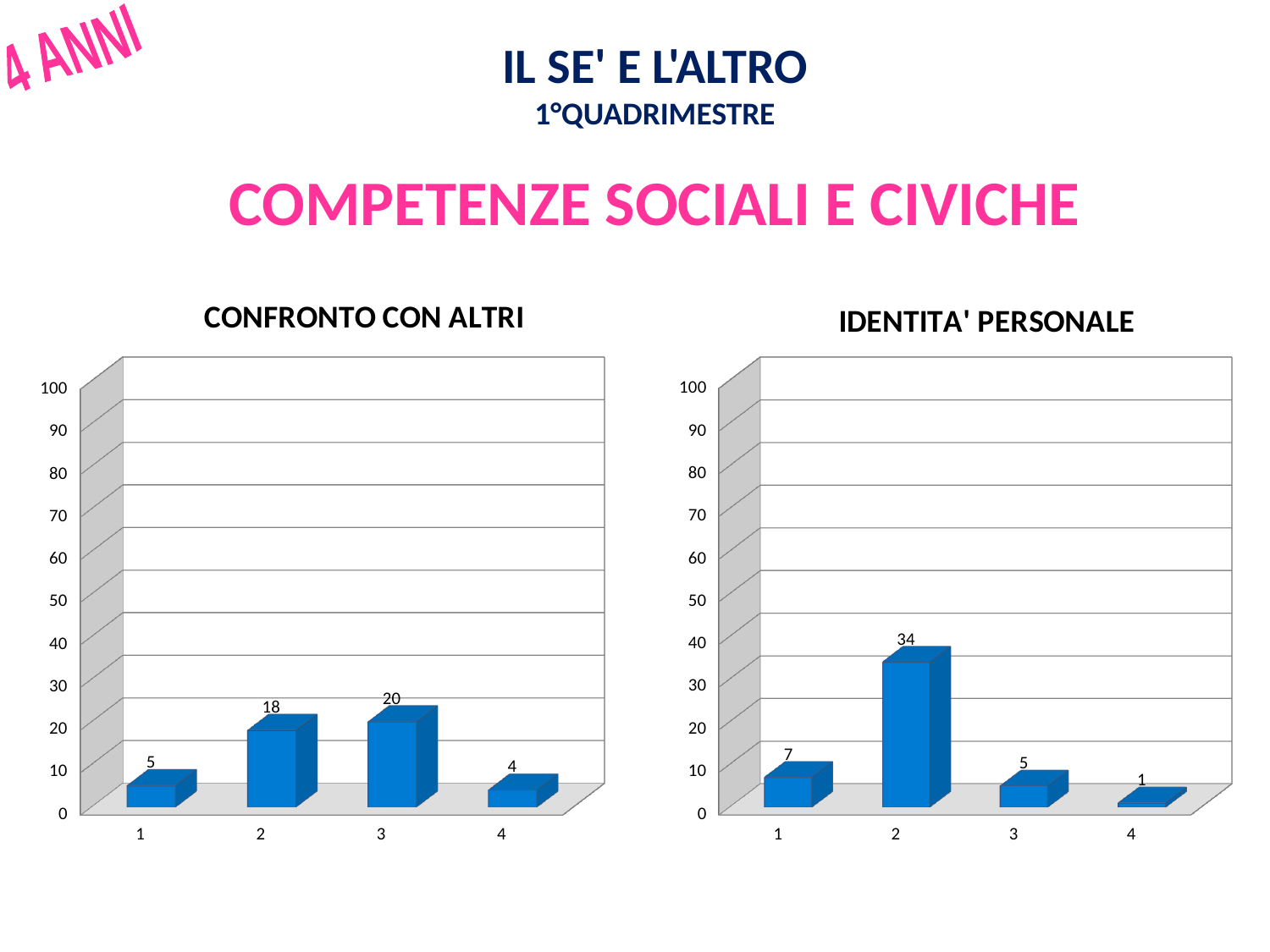
In the CONFRONTO CON ALTRI chart, what is the difference between the values for category 3 and category 1? 15 How many categories are shown in the CONFRONTO CON ALTRI chart? 4 In the IDENTITA' PERSONALE chart, what is the value for category 1? 7 In the CONFRONTO CON ALTRI chart, what is the value for category 4? 4 In the IDENTITA' PERSONALE chart, what is the difference between the values for category 2 and category 3? 29 In the CONFRONTO CON ALTRI chart, which category has the highest value? 3 In the CONFRONTO CON ALTRI chart, what is the value for category 2? 18 In the IDENTITA' PERSONALE chart, is the value for category 2 greater or less than 30? greater In the IDENTITA' PERSONALE chart, which is larger: the value for category 1 or the value for category 3? category 1 In the IDENTITA' PERSONALE chart, what is the value for category 2? 34 What kind of chart is the IDENTITA' PERSONALE chart? bar chart In the IDENTITA' PERSONALE chart, which category has the lowest value? 4